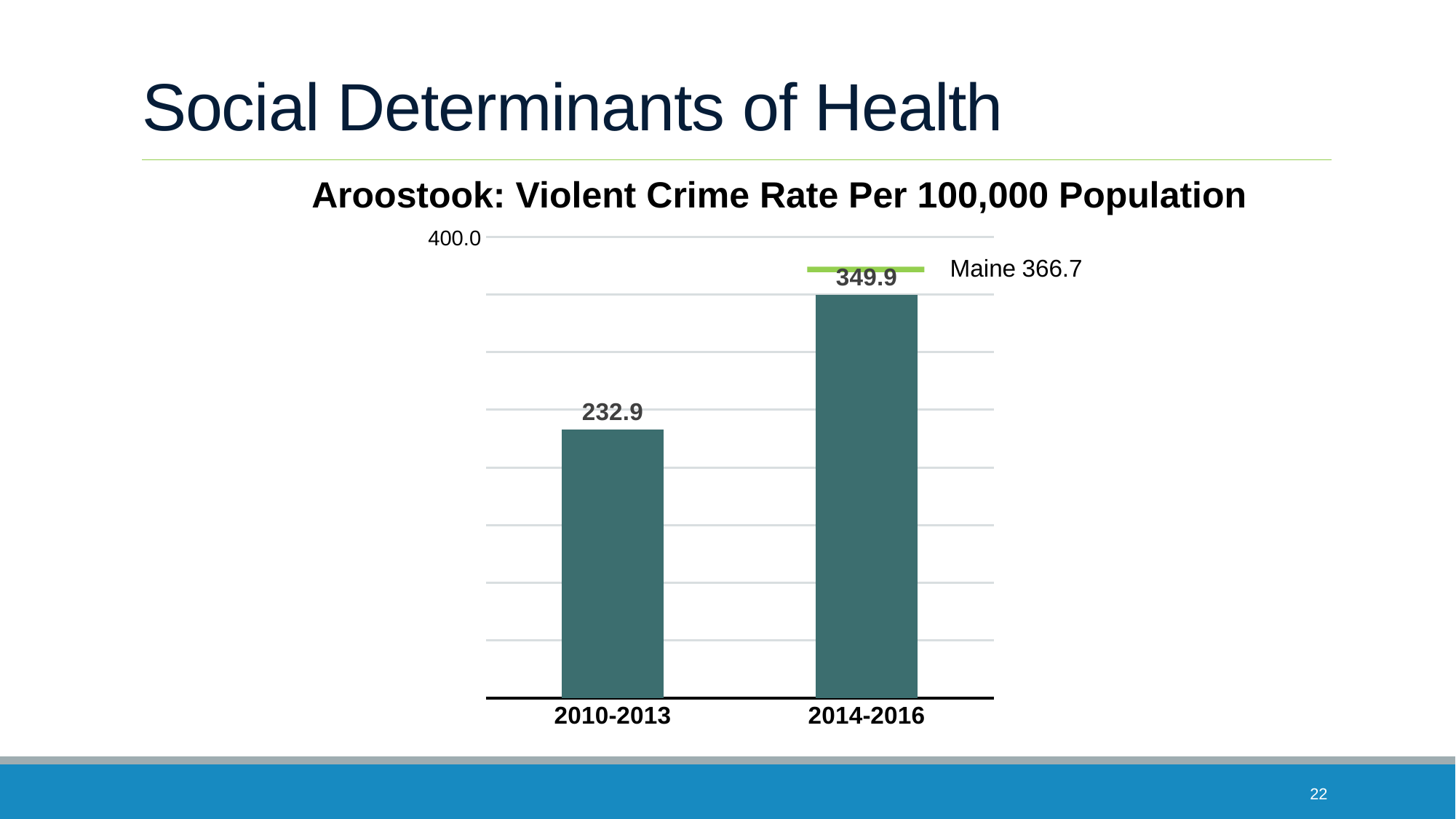
Which period has the higher violent crime rate for Aroostook? 2014-2016 What kind of chart is shown on the slide? Bar chart By how much did Aroostook's violent crime rate increase from 2010-2013 to 2014-2016? 117.0 What is the violent crime rate per 100,000 population for Aroostook in 2010-2013? 232.9 Does Aroostook's violent crime rate rise or fall from 2010-2013 to 2014-2016? Rise Is the Aroostook violent crime rate for 2014-2016 greater or less than the 2010-2013 rate? greater What is the violent crime rate per 100,000 population for Aroostook in 2014-2016? 349.9 Is the Aroostook violent crime rate for 2014-2016 greater or less than 400.0? less What is the title of the chart? Aroostook: Violent Crime Rate Per 100,000 Population What is the Maine violent crime rate shown as a reference on the chart? 366.7 Which period has the lower violent crime rate for Aroostook? 2010-2013 How many time periods are shown on the chart? 2